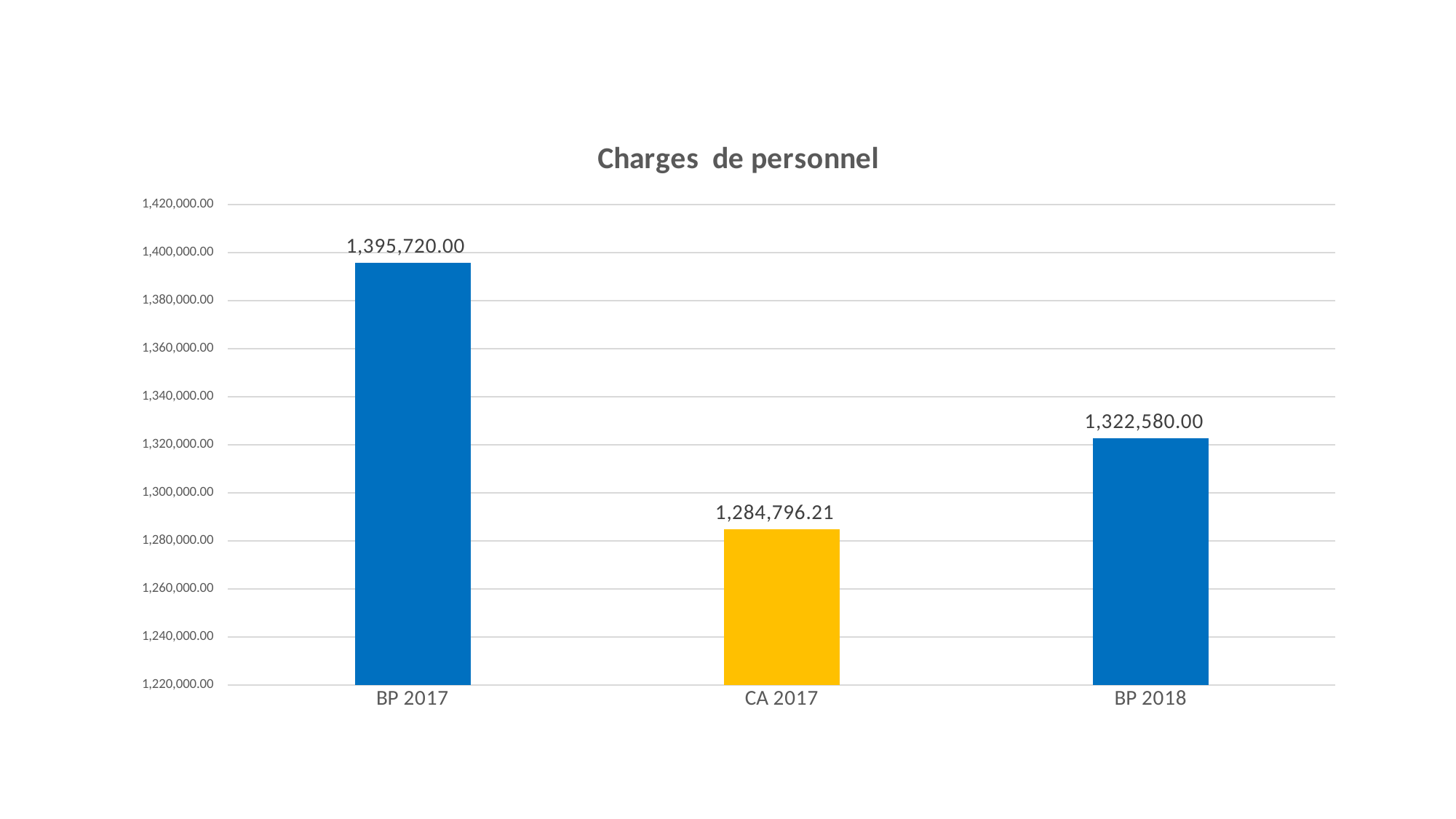
What is the value for BP 2018? 1,322,580.00 What is the title of the chart? Charges de personnel What kind of chart is shown on the slide? bar chart Which category has the highest value? BP 2017 What is the value for BP 2017? 1,395,720.00 What is the value for CA 2017? 1,284,796.21 How many categories are shown on the x axis? 3 Which category has the lowest value? CA 2017 Is the value for CA 2017 greater or less than 1,300,000.00? less Which is larger, the value for CA 2017 or the value for BP 2018? BP 2018 What is the difference between the values for BP 2017 and BP 2018? 73,140.00 What is the difference between the values for BP 2018 and CA 2017? 37,783.79